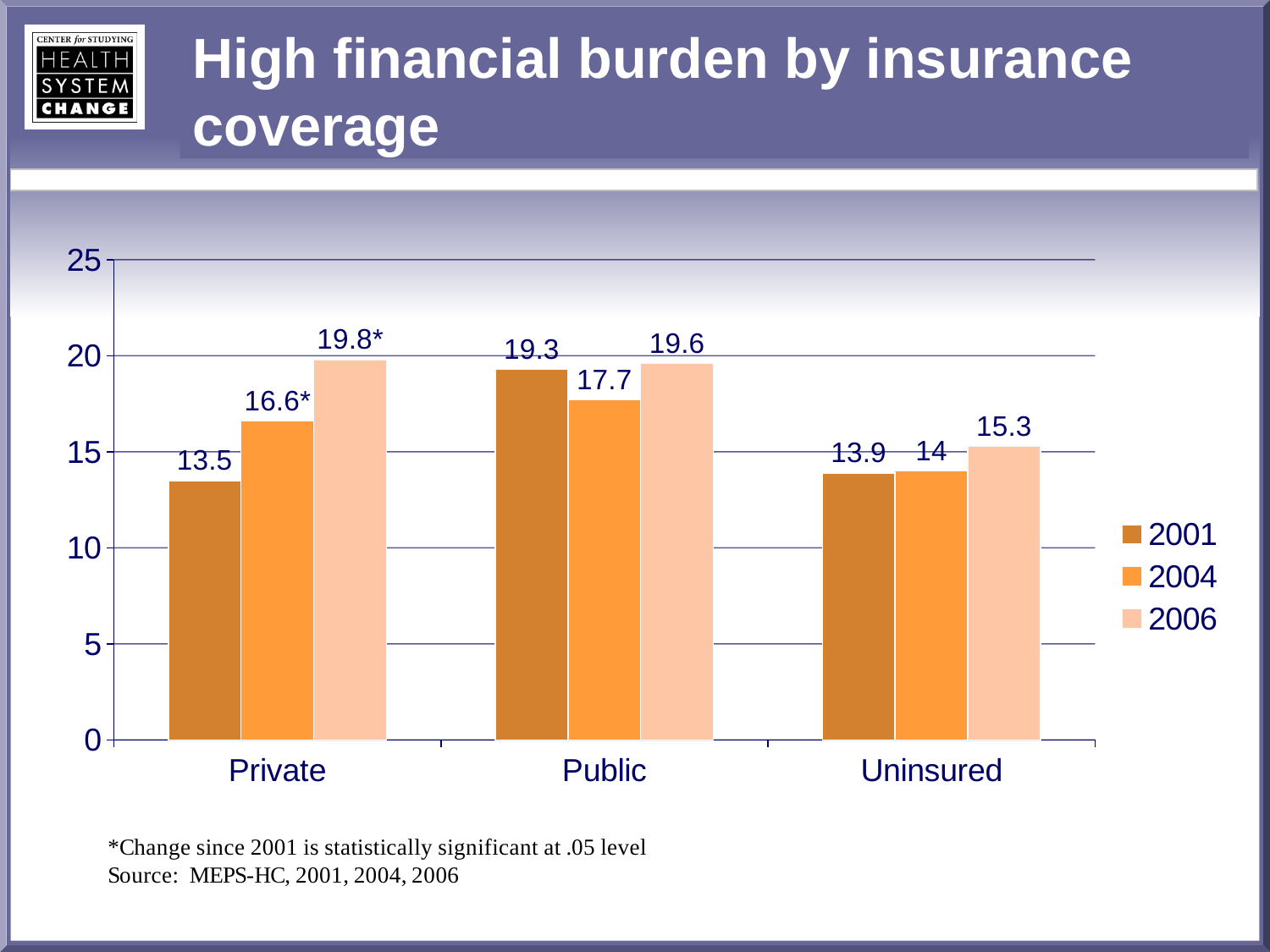
Which years are listed in the legend? 2001, 2004, 2006 What is the value for Uninsured in 2006? 15.3 Which category has the lowest value in 2006? Uninsured What is the value for Public in 2004? 17.7 How many insurance coverage categories are shown on the x axis? 3 What is the difference between the 2006 and 2001 values for Private? 6.3 How many series does the legend list? 3 What kind of chart is shown on the slide? bar chart Is the 2006 value for Public greater or less than 15? greater Which category has the highest value in 2001? Public Which is larger, the 2004 value for Public or the 2004 value for Uninsured? Public What is the value for Private in 2001? 13.5